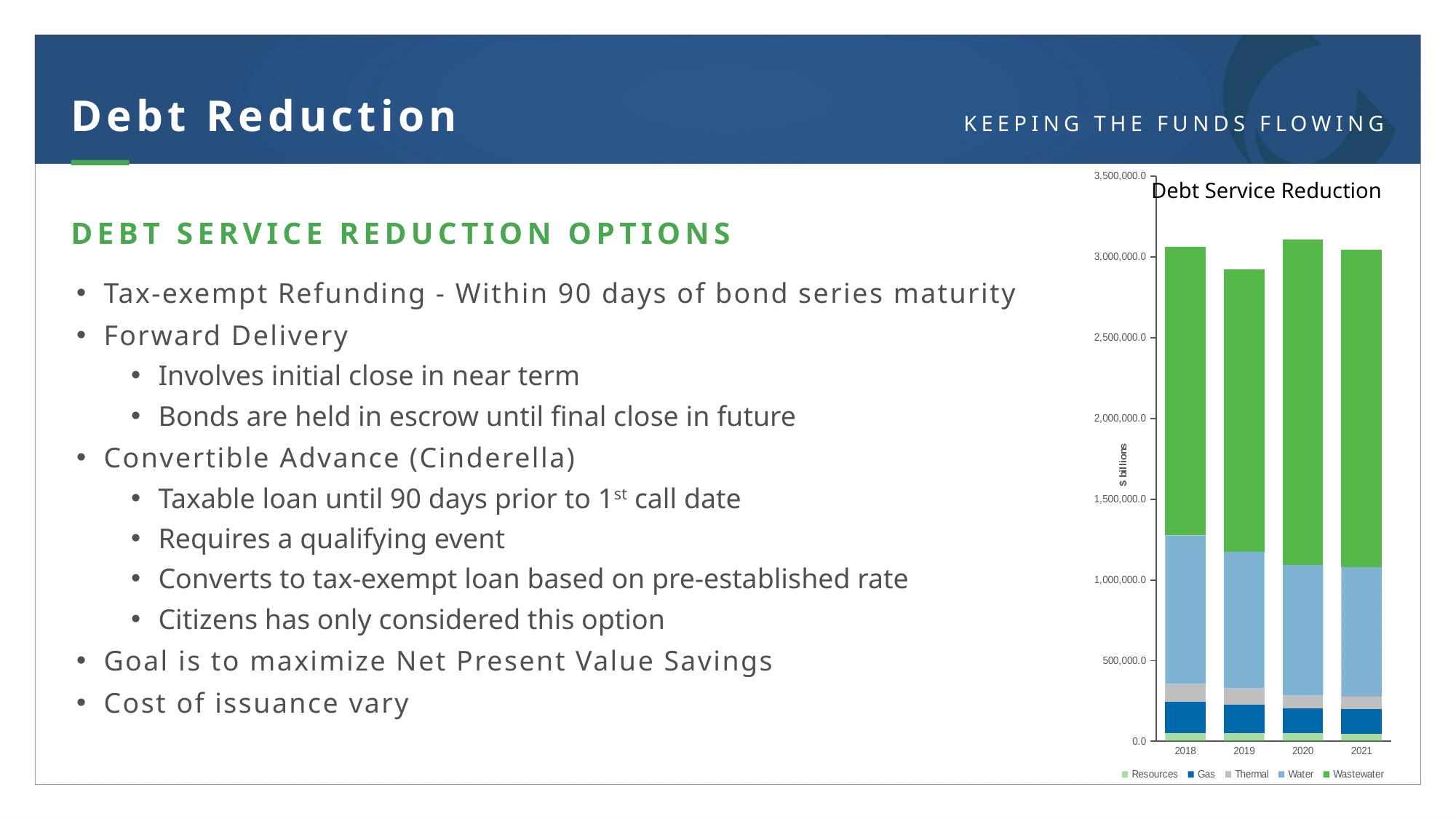
What is the first year shown on the x axis of the Debt Service Reduction chart? 2018 What kind of chart is the Debt Service Reduction chart? Stacked bar chart Which year has the highest total bar in the Debt Service Reduction chart? 2020 What is the y-axis label of the Debt Service Reduction chart? $ billions How many series does the legend of the Debt Service Reduction chart list? 5 Which year has the lowest total bar in the Debt Service Reduction chart? 2019 Is the total bar for 2020 in the Debt Service Reduction chart greater or less than 3,000,000.0? greater How many years are shown on the x axis of the Debt Service Reduction chart? 4 Which series occupies the largest segment of each bar in the Debt Service Reduction chart? Wastewater Is the total bar for 2018 in the Debt Service Reduction chart greater or less than 2,500,000.0? greater Is the total bar for 2019 in the Debt Service Reduction chart greater or less than 3,000,000.0? less Is the total bar for 2019 larger or smaller than the total bar for 2020 in the Debt Service Reduction chart? smaller